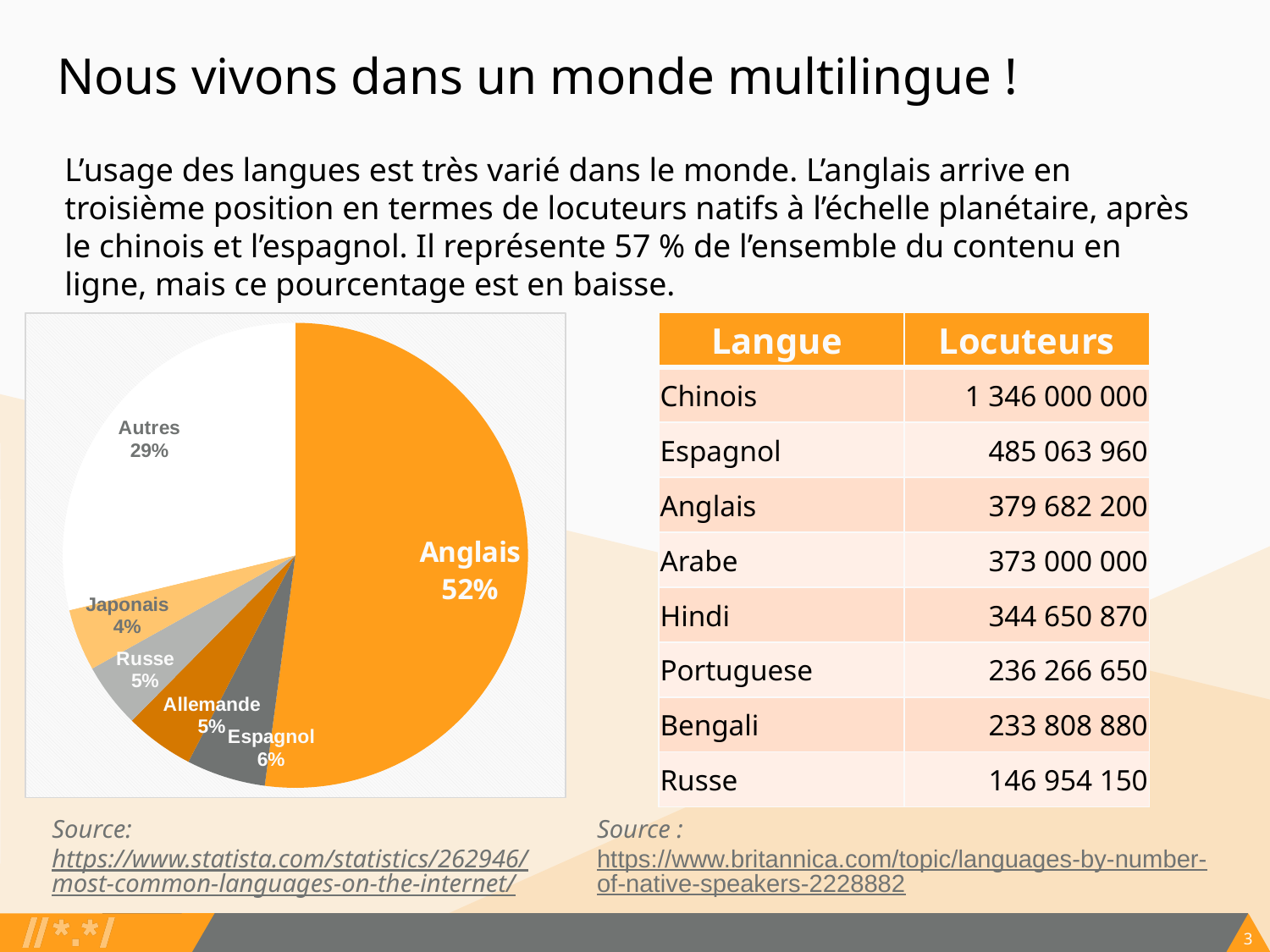
Which slice of the pie chart is the smallest? Japonais Which is larger in the pie chart, Espagnol or Japonais? Espagnol What is the difference between the Anglais share and the Autres share in the pie chart? 23% What is the combined share of Russe and Allemande in the pie chart? 10% What share of the pie does Russe have? 5% How many slices does the pie chart have? 6 Which slice of the pie chart is the largest? Anglais What share of the pie does Japonais have? 4% What share of the pie does Espagnol have? 6% What kind of chart is shown on the slide? pie chart What share of the pie does Anglais have? 52% What share of the pie does Autres have? 29%